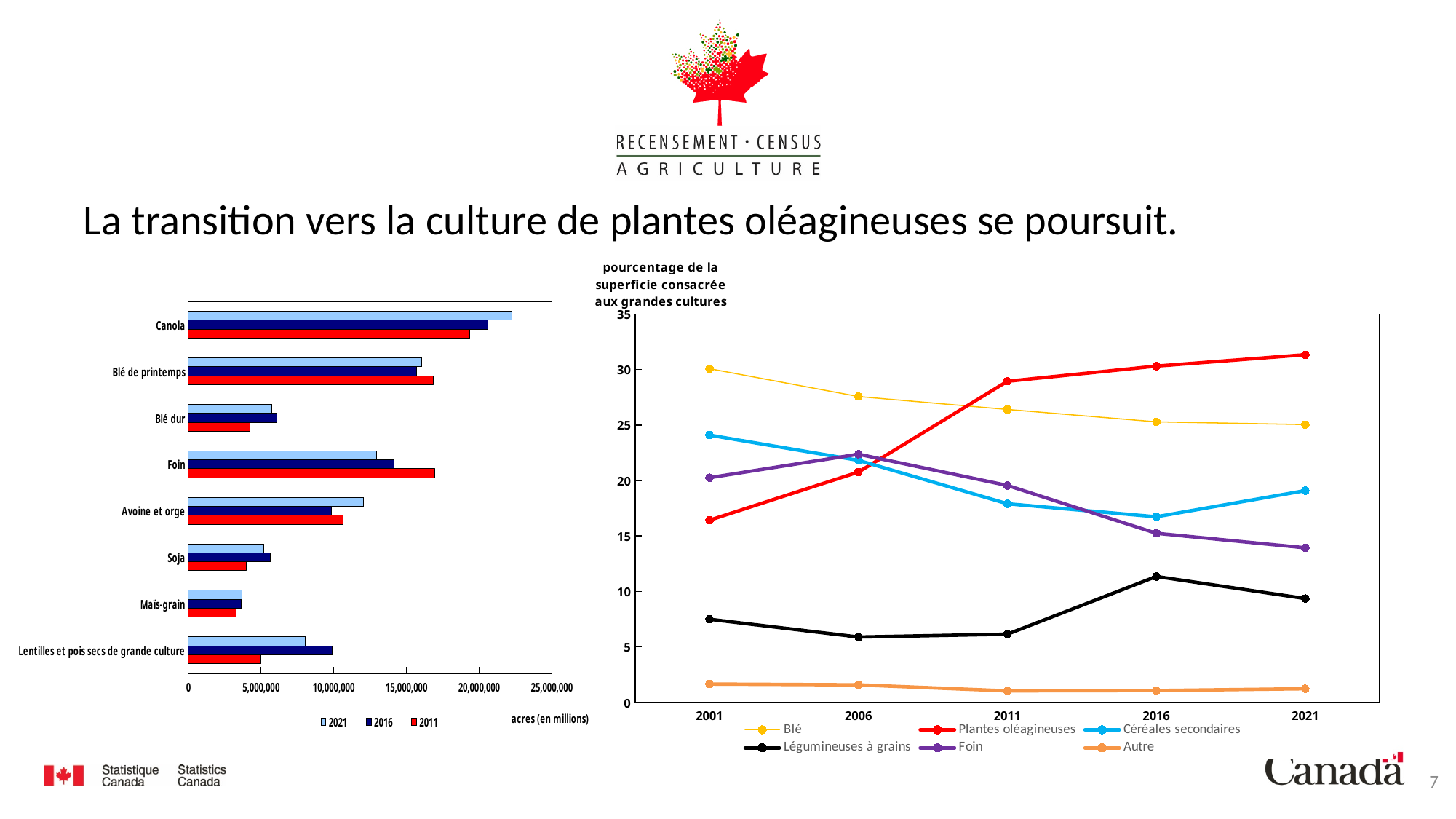
What kind of chart is the chart titled 'pourcentage de la superficie consacrée aux grandes cultures'? line chart In the bar chart on the left, how many crop categories are shown? 8 In the chart titled 'pourcentage de la superficie consacrée aux grandes cultures', does the Blé series rise or fall from 2001 to 2021? fall In the chart titled 'pourcentage de la superficie consacrée aux grandes cultures', how many series does the legend list? 6 In the bar chart on the left, is the 2021 value for Canola greater or less than 20,000,000? greater In the bar chart on the left, which crop has the highest value for 2021? Canola In the bar chart on the left, how many series does the legend list? 3 In the bar chart on the left, which is larger for Foin: the 2011 value or the 2021 value? 2011 In the chart titled 'pourcentage de la superficie consacrée aux grandes cultures', which series has the highest value in 2021? Plantes oléagineuses In the chart titled 'pourcentage de la superficie consacrée aux grandes cultures', is the value for Plantes oléagineuses in 2021 greater or less than 30? greater In the bar chart on the left, which crop has the lowest value for 2021? Maïs-grain What kind of chart is the chart on the left of the slide? bar chart